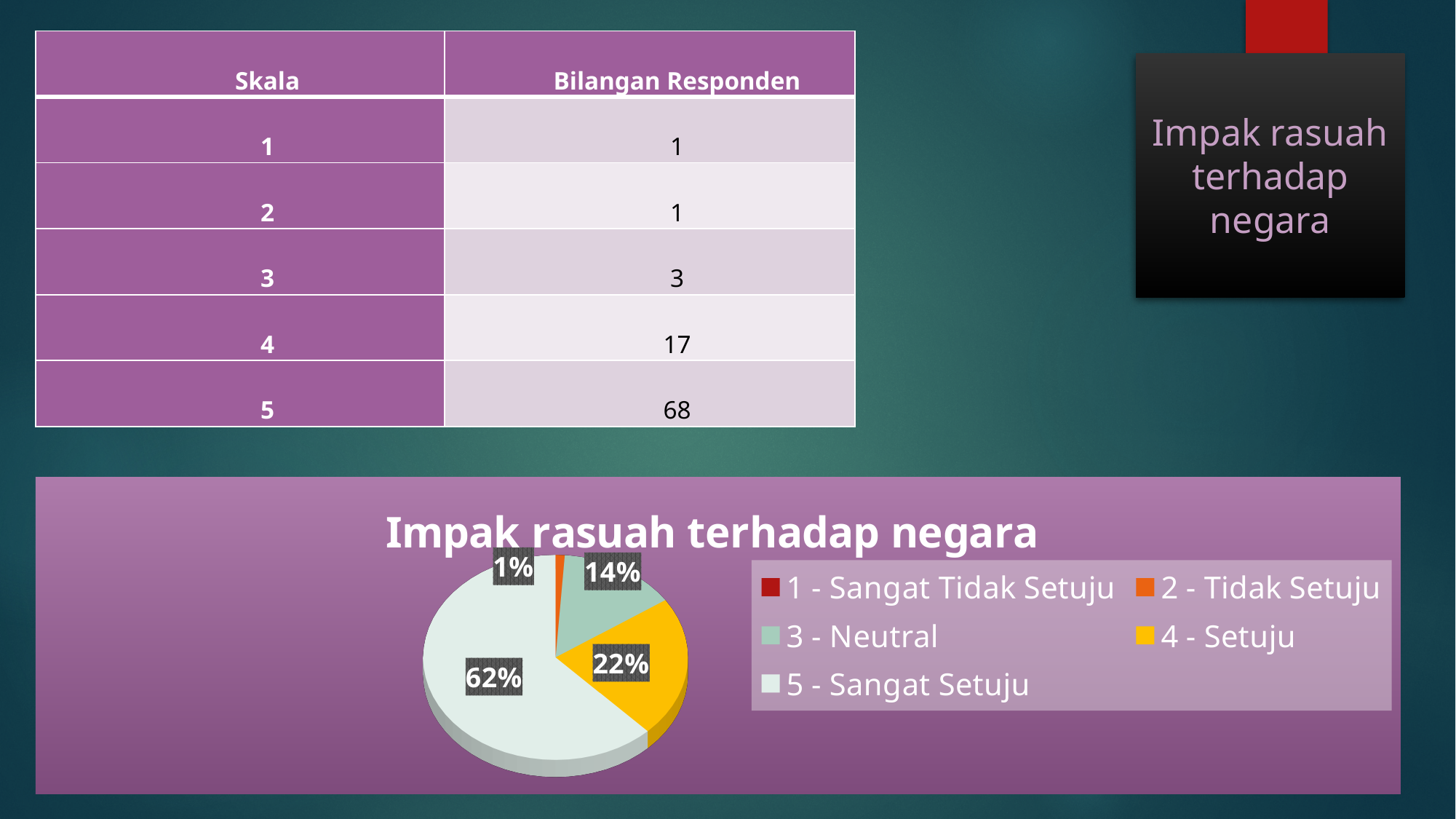
What is the difference in percentage points between the 4 - Setuju slice and the 3 - Neutral slice? 8 percentage points Which slice is larger, 4 - Setuju or 3 - Neutral? 4 - Setuju What is the difference in percentage points between the 5 - Sangat Setuju slice and the 4 - Setuju slice? 40 percentage points What percentage of the pie is labelled for 5 - Sangat Setuju? 62% Is the 5 - Sangat Setuju slice greater or less than 50% of the pie? greater How many categories does the chart legend list? 5 What kind of chart is shown on the slide? pie chart What is the title of the chart? Impak rasuah terhadap negara What percentage of the pie is labelled for 3 - Neutral? 14% What percentage of the pie is labelled for 4 - Setuju? 22% Which category has the largest slice of the pie? 5 - Sangat Setuju What colour represents 4 - Setuju in the pie chart? yellow